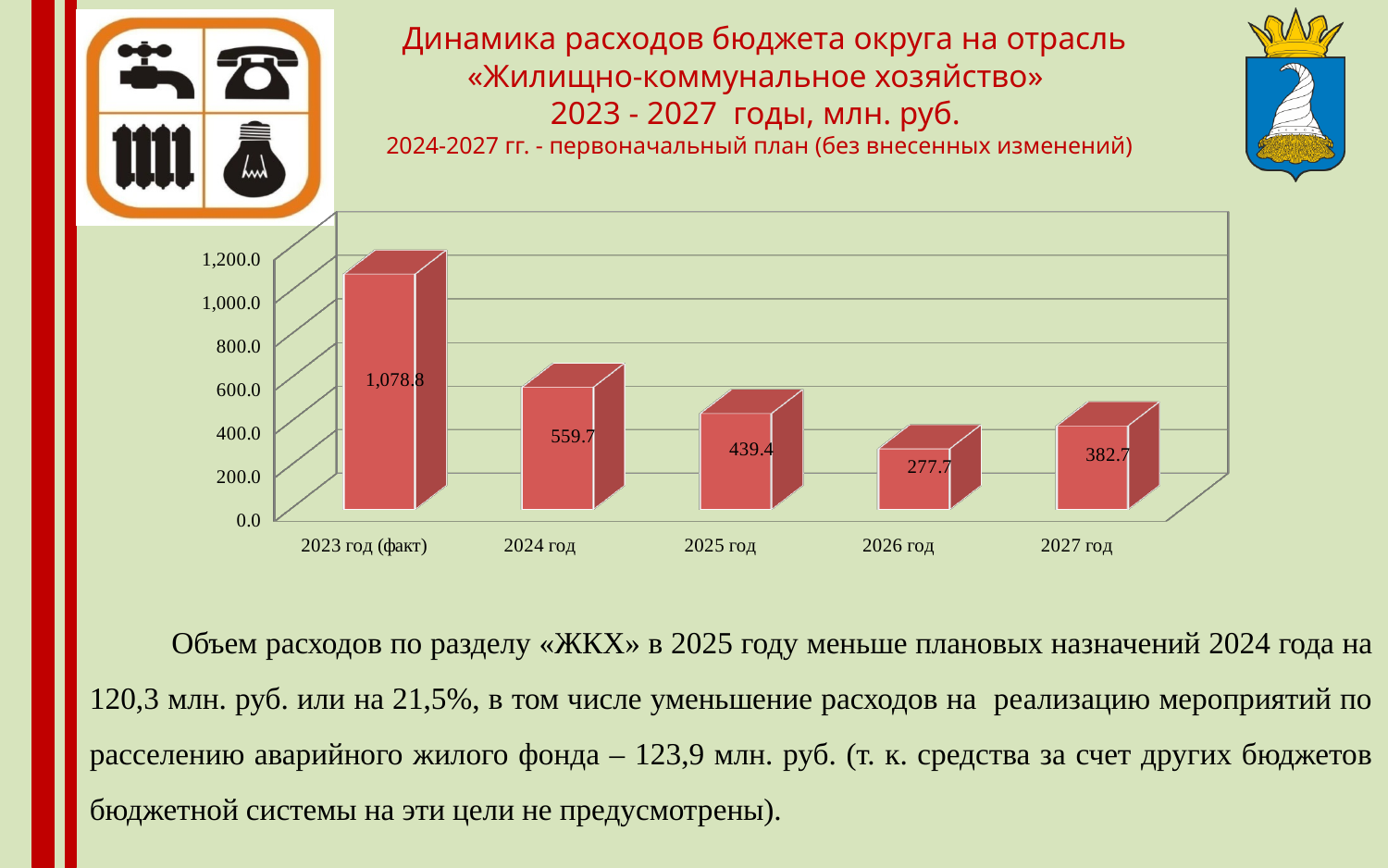
Do the values rise or fall from 2023 год (факт) to 2026 год? fall Which year has the lowest value? 2026 год What kind of chart is shown on the slide? bar chart Which year has the highest value? 2023 год (факт) What is the value for 2023 год (факт)? 1,078.8 How many years are shown on the x axis? 5 What is the difference between the values for 2023 год (факт) and 2024 год? 519.1 What is the value for 2025 год? 439.4 Is the value for 2024 год greater or less than 600.0? less What is the value for 2027 год? 382.7 Which is larger, the value for 2026 год or the value for 2027 год? 2027 год What is the difference between the values for 2024 год and 2025 год? 120.3